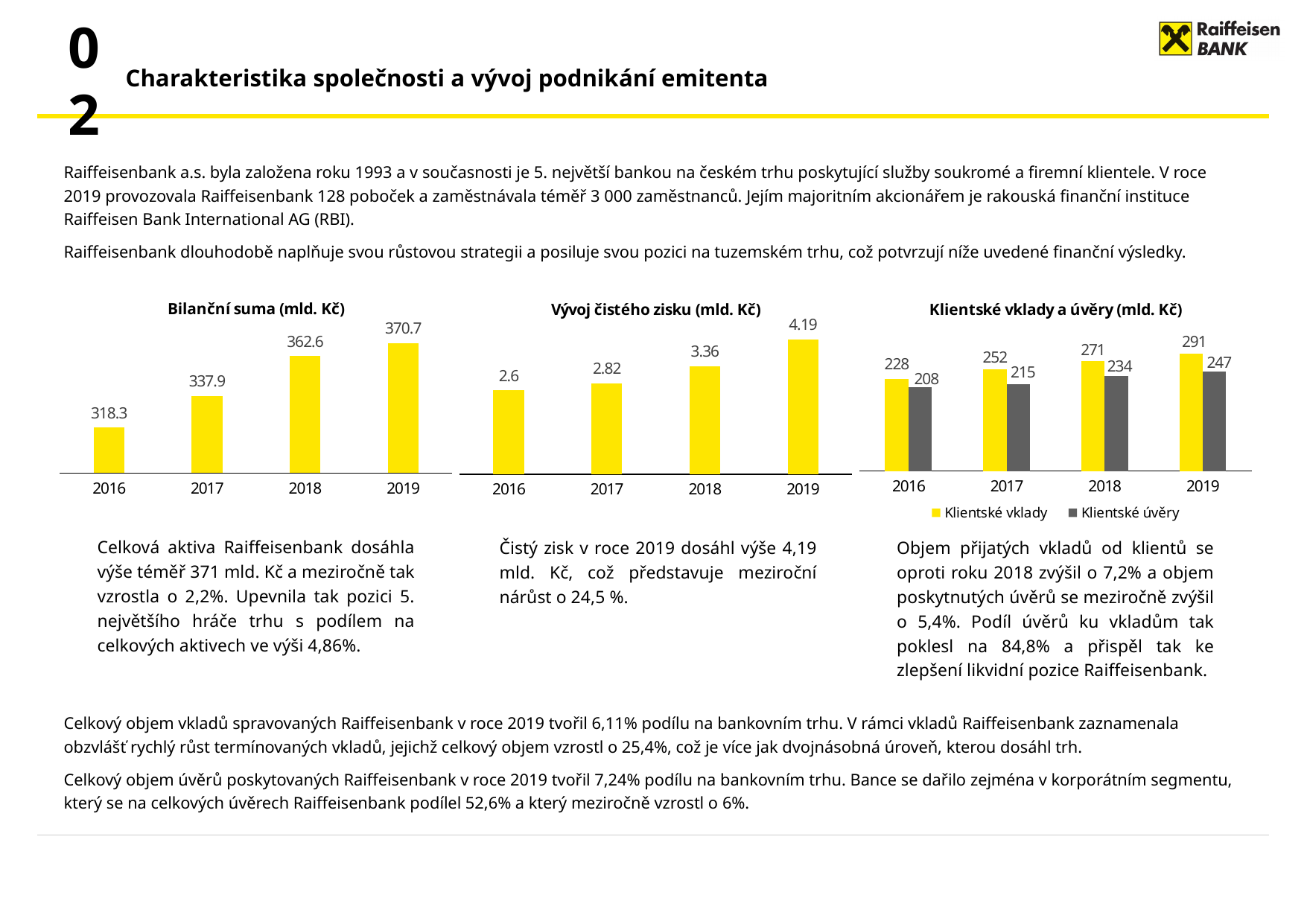
In the 'Klientské vklady a úvěry (mld. Kč)' chart, how many series does the legend list? 2 In the 'Bilanční suma (mld. Kč)' chart, what is the difference between the 2019 and 2018 values? 8.1 In the 'Klientské vklady a úvěry (mld. Kč)' chart, which is larger in 2019, Klientské vklady or Klientské úvěry? Klientské vklady In the 'Bilanční suma (mld. Kč)' chart, do the values rise or fall from 2016 to 2019? rise In the 'Klientské vklady a úvěry (mld. Kč)' chart, what is the value of Klientské úvěry for 2018? 234 In the 'Vývoj čistého zisku (mld. Kč)' chart, which year has the lowest value? 2016 In the 'Bilanční suma (mld. Kč)' chart, which year has the highest value? 2019 What type of chart is the 'Vývoj čistého zisku (mld. Kč)' chart? bar chart In the 'Klientské vklady a úvěry (mld. Kč)' chart, what is the difference between Klientské vklady and Klientské úvěry in 2017? 37 In the 'Bilanční suma (mld. Kč)' chart, what is the value for 2017? 337.9 In the 'Vývoj čistého zisku (mld. Kč)' chart, what is the value for 2018? 3.36 In the 'Vývoj čistého zisku (mld. Kč)' chart, how many years are shown? 4